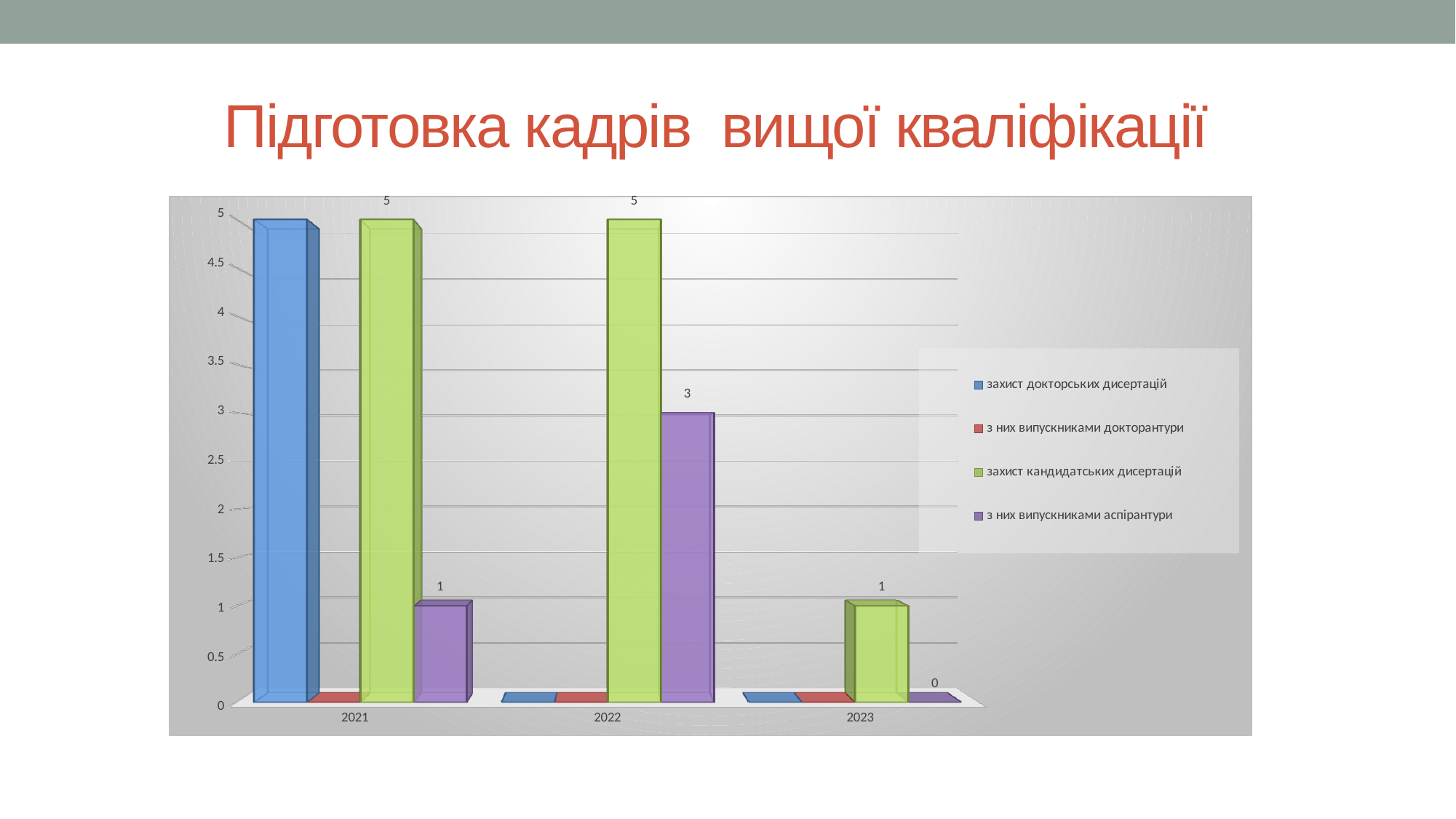
What kind of chart is shown on the slide? bar chart In 2022, what is the difference between захист кандидатських дисертацій and з них випускниками аспірантури? 2 In which year is the value for з них випускниками аспірантури the highest? 2022 What is the value for з них випускниками аспірантури in 2021? 1 What is the value for захист кандидатських дисертацій in 2023? 1 How many series does the legend list? 4 What is the value for з них випускниками аспірантури in 2022? 3 What is the value for з них випускниками аспірантури in 2023? 0 Is the value for захист докторських дисертацій in 2021 greater or less than 4? greater In which year is the value for захист кандидатських дисертацій the lowest? 2023 What is the value for захист кандидатських дисертацій in 2022? 5 Is the value for з них випускниками аспірантури larger in 2021 or in 2022? 2022